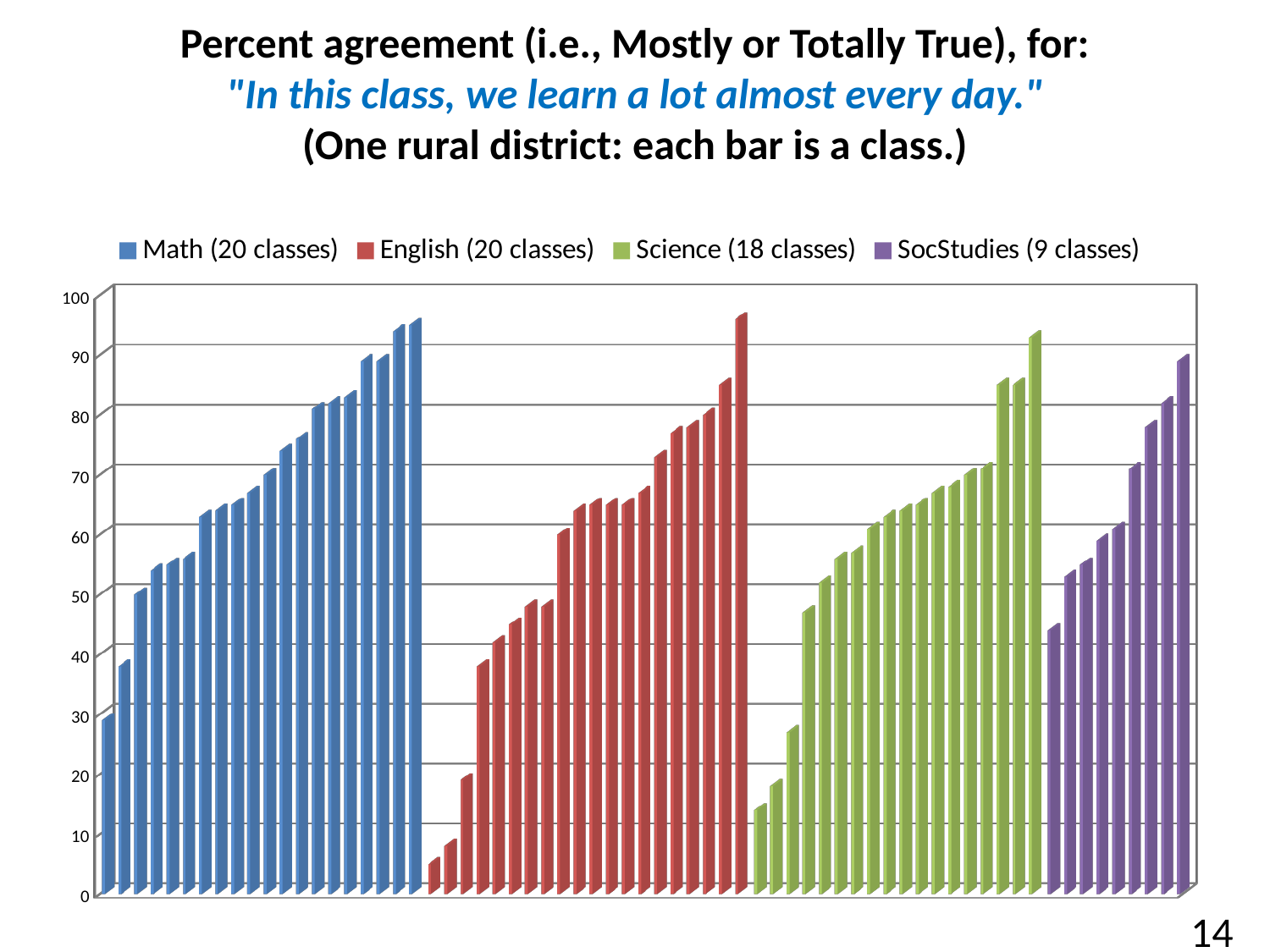
Which series contains the lowest bar on the chart? English Is the value for the highest English bar greater or less than 90? greater According to the legend, how many SocStudies classes are plotted? 9 Which subject has the fewest classes according to the legend? SocStudies Within each subject group, do the bars rise or fall from left to right? rise Is the value for the lowest Math bar greater or less than 40? less Is the value for the lowest English bar greater or less than 10? less What kind of chart is shown on the slide? bar chart Which colour represents the English classes? red According to the legend, how many Science classes are plotted? 18 How many series does the legend list? 4